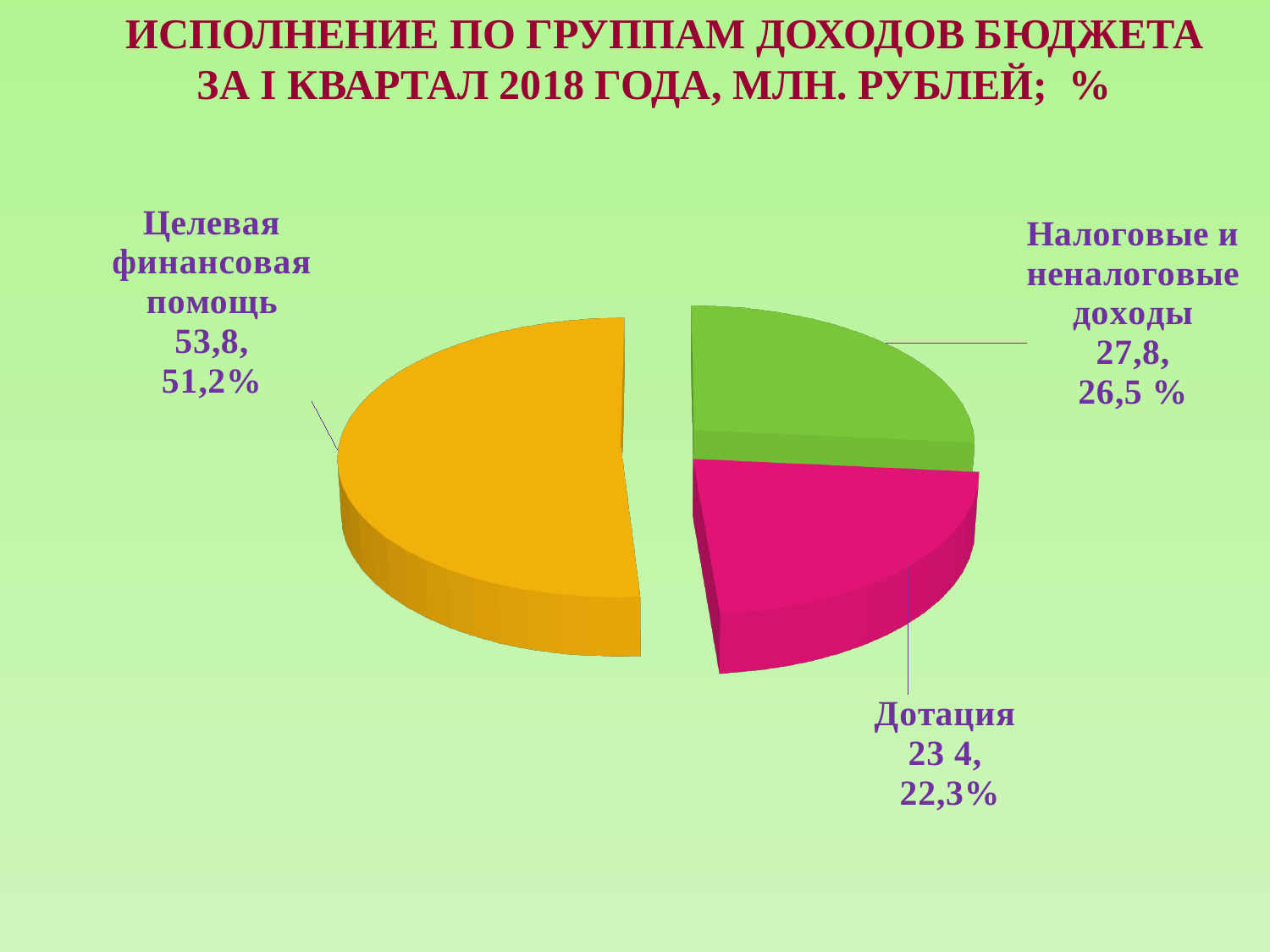
What is the value in million rubles for Налоговые и неналоговые доходы? 27,8 What share of the pie does Налоговые и неналоговые доходы represent? 26,5 % What colour is the slice for Дотация? magenta (pink) How many slices does the pie chart have? 3 Which income group has the smallest slice? Дотация What is the value in million rubles for Целевая финансовая помощь? 53,8 Which is larger, Целевая финансовая помощь or Налоговые и неналоговые доходы? Целевая финансовая помощь What share of the pie does Дотация represent? 22,3% Which income group has the largest slice? Целевая финансовая помощь What is the difference in million rubles between Целевая финансовая помощь and Налоговые и неналоговые доходы? 26,0 What share of the pie does Целевая финансовая помощь represent? 51,2% What kind of chart is shown on the slide? pie chart